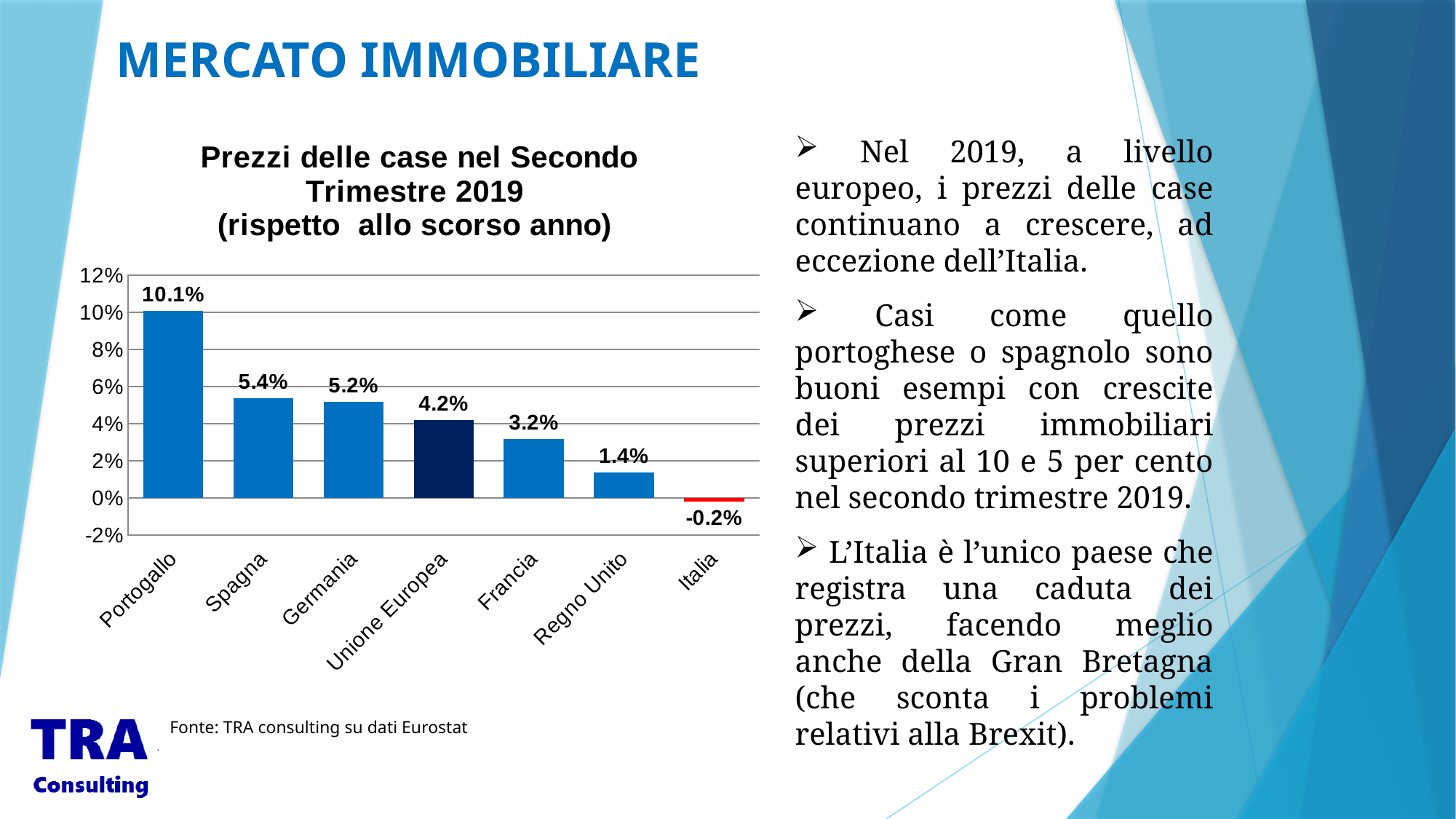
What kind of chart is shown on the slide? bar chart What is the value for Italia? -0.2% What is the title of the chart? Prezzi delle case nel Secondo Trimestre 2019 (rispetto allo scorso anno) Which is larger, the value for Francia or the value for Regno Unito? Francia What is the difference between the values for Spagna and Germania? 0.2% What is the difference between the values for Portogallo and Francia? 6.9% Which category has the highest value? Portogallo Which category has the lowest value? Italia Is the value for Spagna greater or less than 4%? greater What is the value for Portogallo? 10.1% How many categories are shown on the x axis? 7 What is the value for Unione Europea? 4.2%